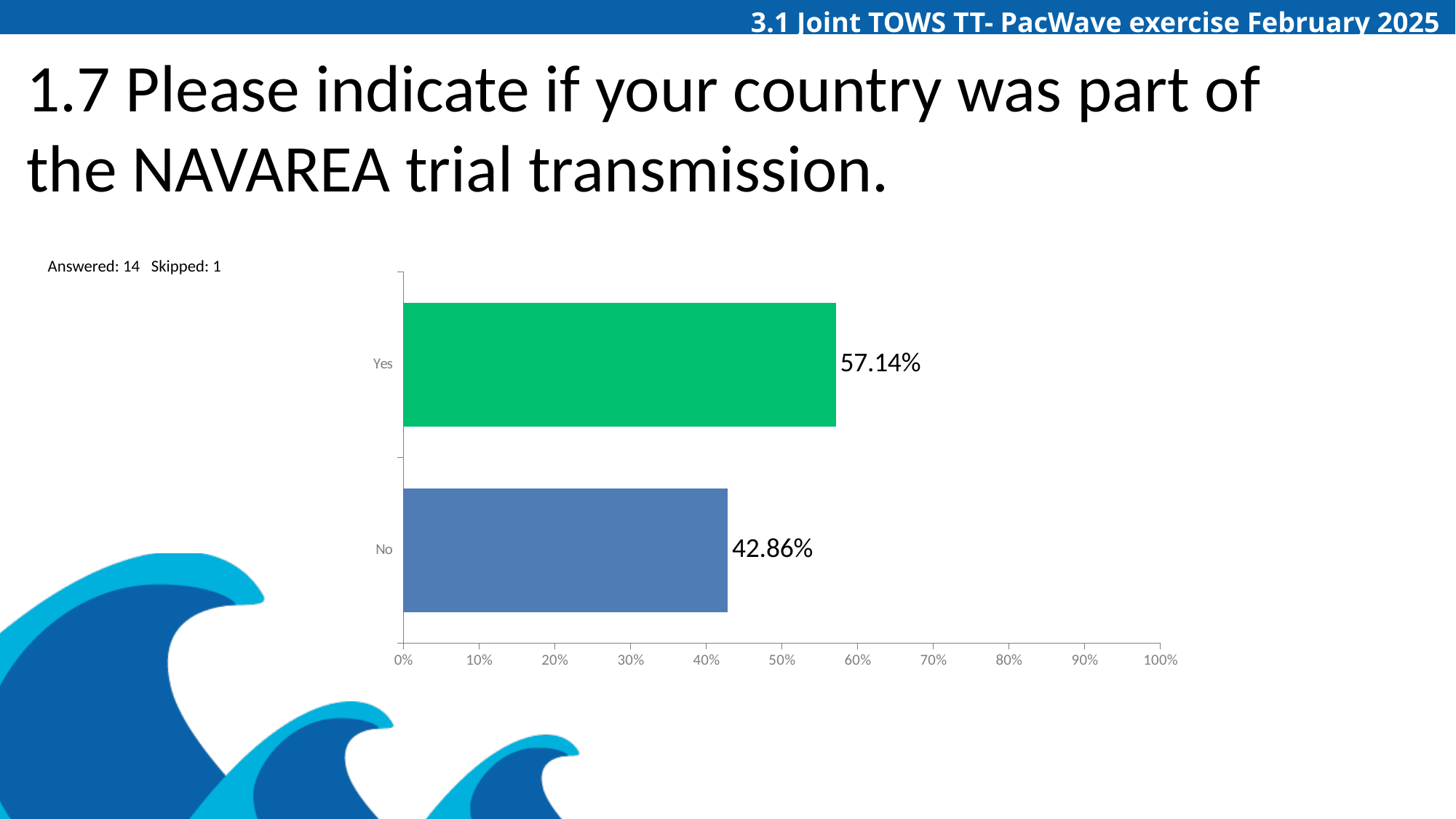
What kind of chart is shown on the slide? bar chart What percentage of respondents answered No? 42.86% Which category has the highest value? Yes Which category has the lowest value? No What is the difference between the Yes and No percentages? 14.28% What is the total of the Yes and No percentages? 100% How many respondents answered the question according to the slide? 14 What percentage of respondents answered Yes? 57.14% Is the value for No greater or less than 50%? less Is the value for Yes greater or less than 50%? greater How many categories are shown in the chart? 2 Which is larger, the value for Yes or the value for No? Yes